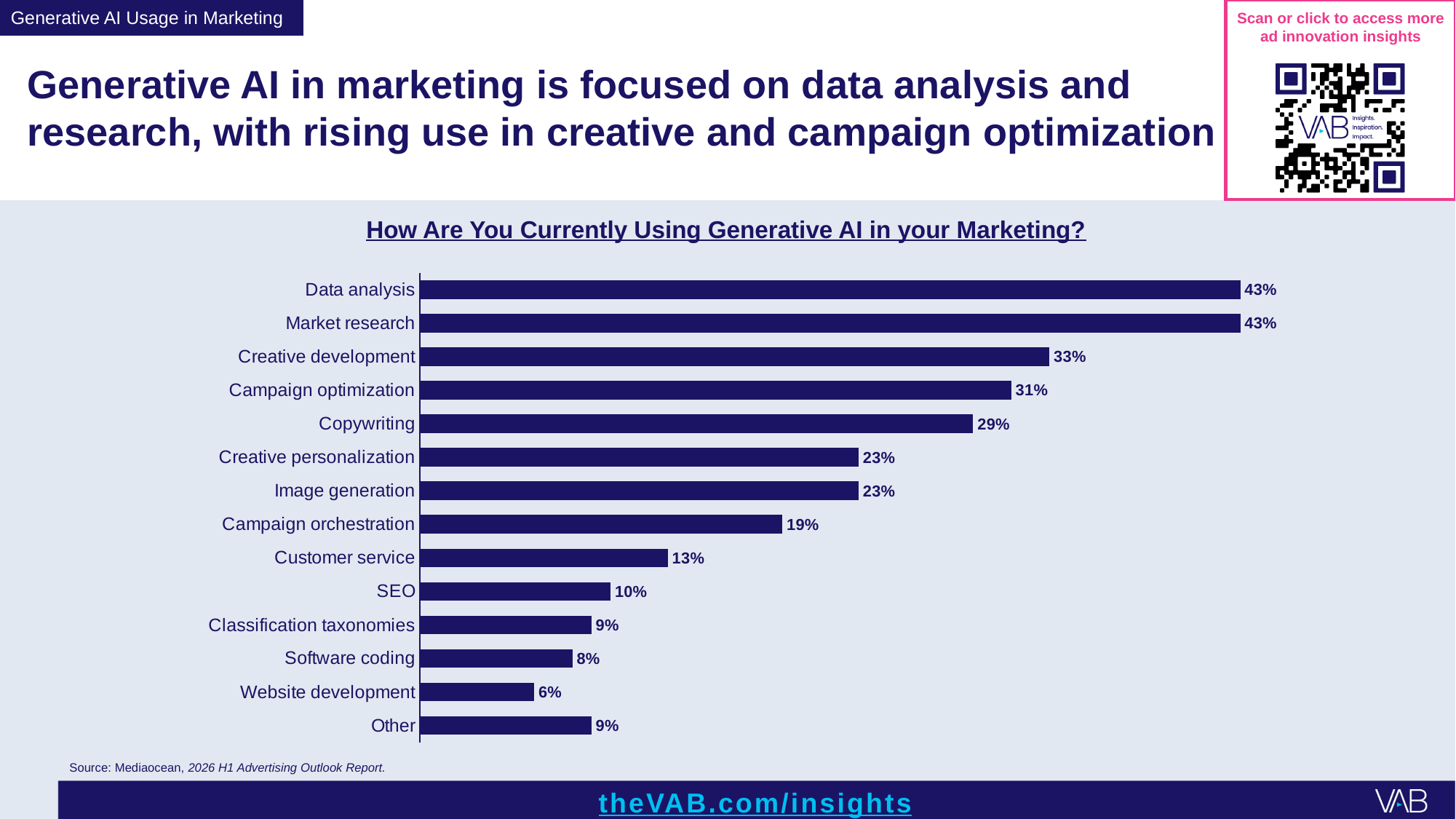
What is the difference between the values for Data analysis and Creative development? 10% How many categories are shown in the chart? 14 What kind of chart is shown on the slide? Bar chart What is the difference between the values for Copywriting and Customer service? 16% What percentage of respondents use generative AI for creative development? 33% What percentage is shown for Website development? 6% What is the title of the chart? How Are You Currently Using Generative AI in your Marketing? Which category has the lowest value in the chart? Website development Which is larger, the value for Campaign optimization or the value for Image generation? Campaign optimization What is the highest value shown in the chart? 43% What is the value shown for SEO? 10% What is the value shown for Campaign orchestration? 19%